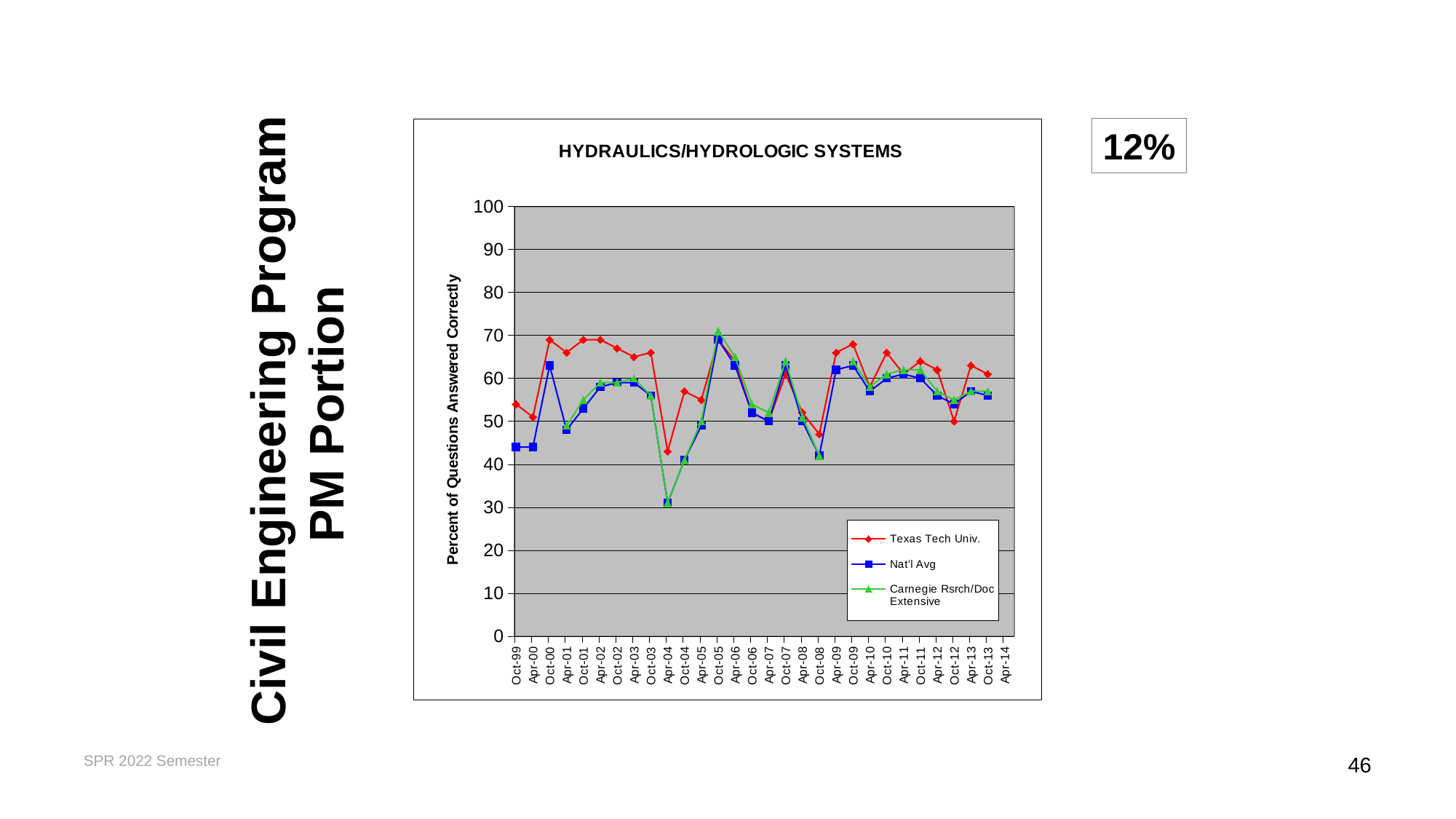
Is the Nat'l Avg value at Oct-99 greater or less than 50? less What kind of chart is shown on the slide? line chart Is the Texas Tech Univ. value at Oct-05 greater or less than 60? greater At Oct-00, which is larger: the Texas Tech Univ. value or the Nat'l Avg value? Texas Tech Univ. Is the Nat'l Avg value at Oct-08 greater or less than 50? less Does the Nat'l Avg series rise or fall from Oct-03 to Apr-04? fall What is the title of the chart? HYDRAULICS/HYDROLOGIC SYSTEMS What is the label on the vertical axis of the chart? Percent of Questions Answered Correctly How many series does the legend list? 3 At which date does the Nat'l Avg series reach its lowest value? Apr-04